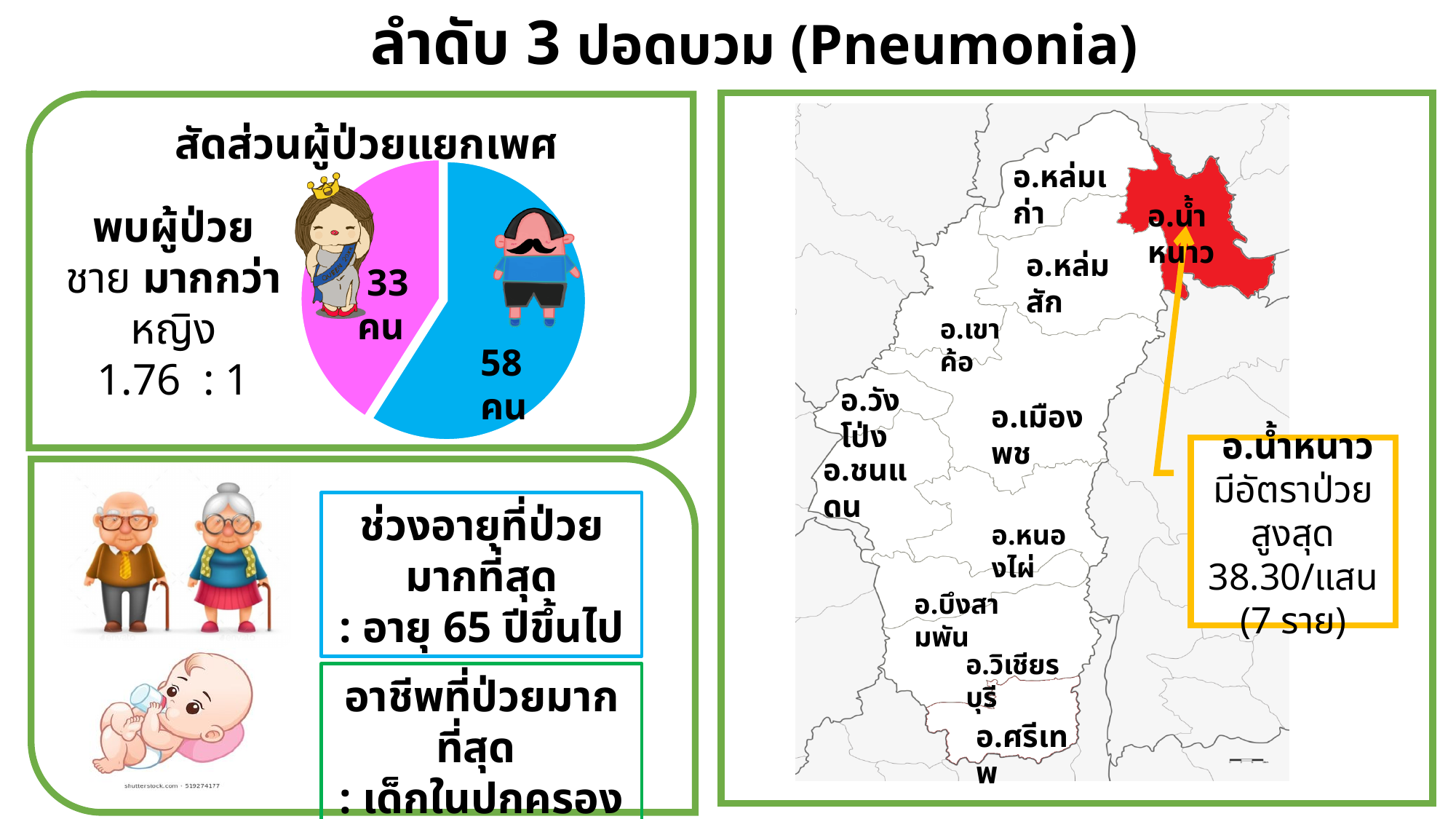
What kind of chart is shown under the title สัดส่วนผู้ป่วยแยกเพศ? pie chart In the pie chart สัดส่วนผู้ป่วยแยกเพศ, how many patients are in the blue (male) slice? 58 คน In the pie chart สัดส่วนผู้ป่วยแยกเพศ, which group has the smallest number of patients? female (pink), 33 คน How many slices does the pie chart สัดส่วนผู้ป่วยแยกเพศ have? 2 In the pie chart สัดส่วนผู้ป่วยแยกเพศ, what is the difference between the male and female patient counts? 25 คน According to the text next to the pie chart, what is the male-to-female ratio of patients? 1.76 : 1 In the pie chart สัดส่วนผู้ป่วยแยกเพศ, which slice is larger, the male (blue) or the female (pink) slice? male (blue), 58 คน In the pie chart สัดส่วนผู้ป่วยแยกเพศ, what is the total number of patients across both slices? 91 คน What is the title of the pie chart on the left of the slide? สัดส่วนผู้ป่วยแยกเพศ In the pie chart สัดส่วนผู้ป่วยแยกเพศ, what colour is the slice representing 58 คน? blue In the pie chart สัดส่วนผู้ป่วยแยกเพศ, what share of all patients does the male (58 คน) slice represent? 63.7% In the pie chart สัดส่วนผู้ป่วยแยกเพศ, how many patients are in the pink (female) slice? 33 คน